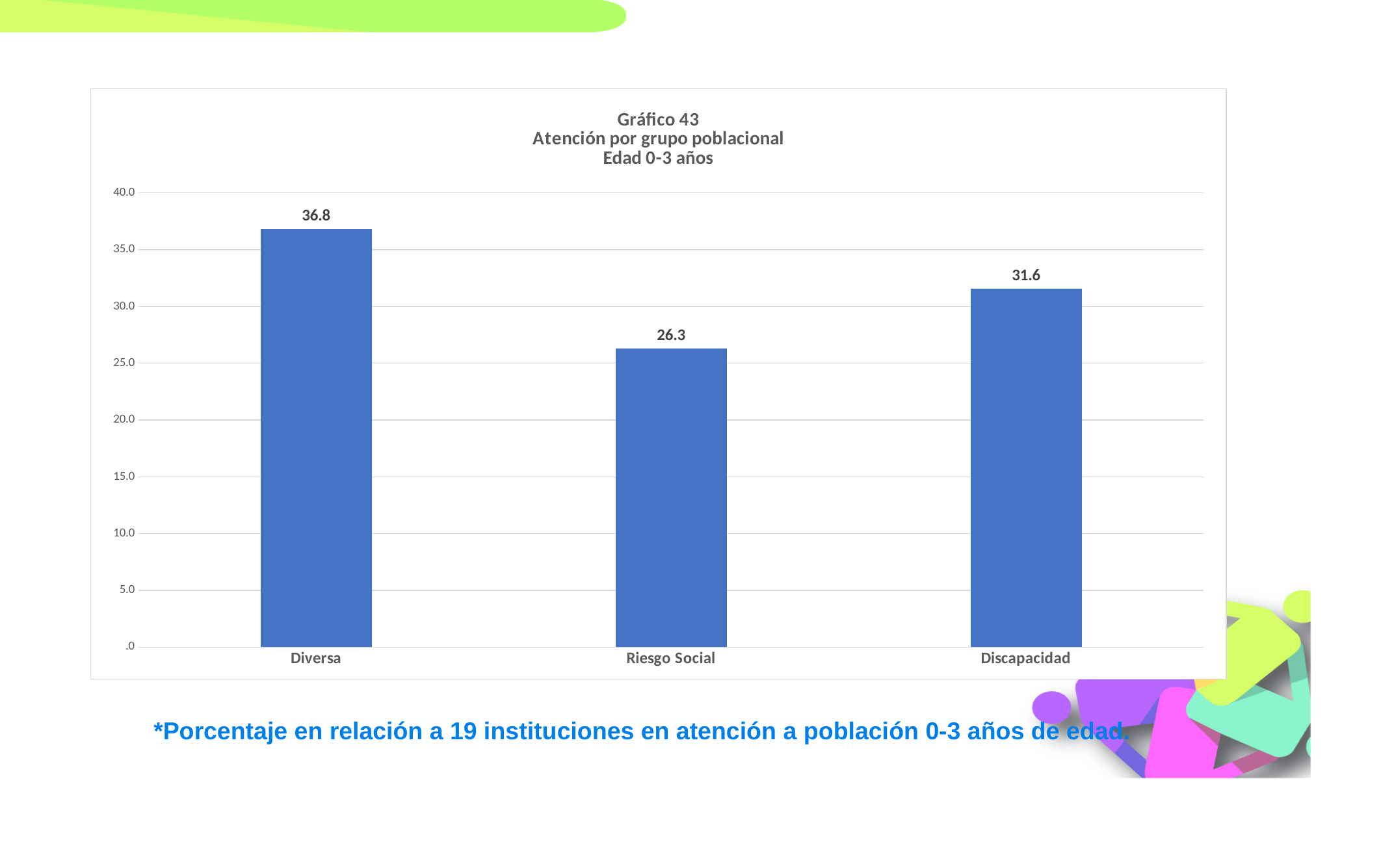
Is the value for Riesgo Social greater or less than 30.0? less What is the title of the chart? Gráfico 43 Atención por grupo poblacional Edad 0-3 años What is the value for Diversa? 36.8 What is the difference between the values for Diversa and Discapacidad? 5.2 What is the value for Discapacidad? 31.6 What kind of chart is shown on the slide? bar chart Which is larger, the value for Discapacidad or the value for Riesgo Social? Discapacidad What is the value for Riesgo Social? 26.3 What is the difference between the values for Diversa and Riesgo Social? 10.5 Which category has the highest value? Diversa Which category has the lowest value? Riesgo Social How many categories are shown on the x axis? 3